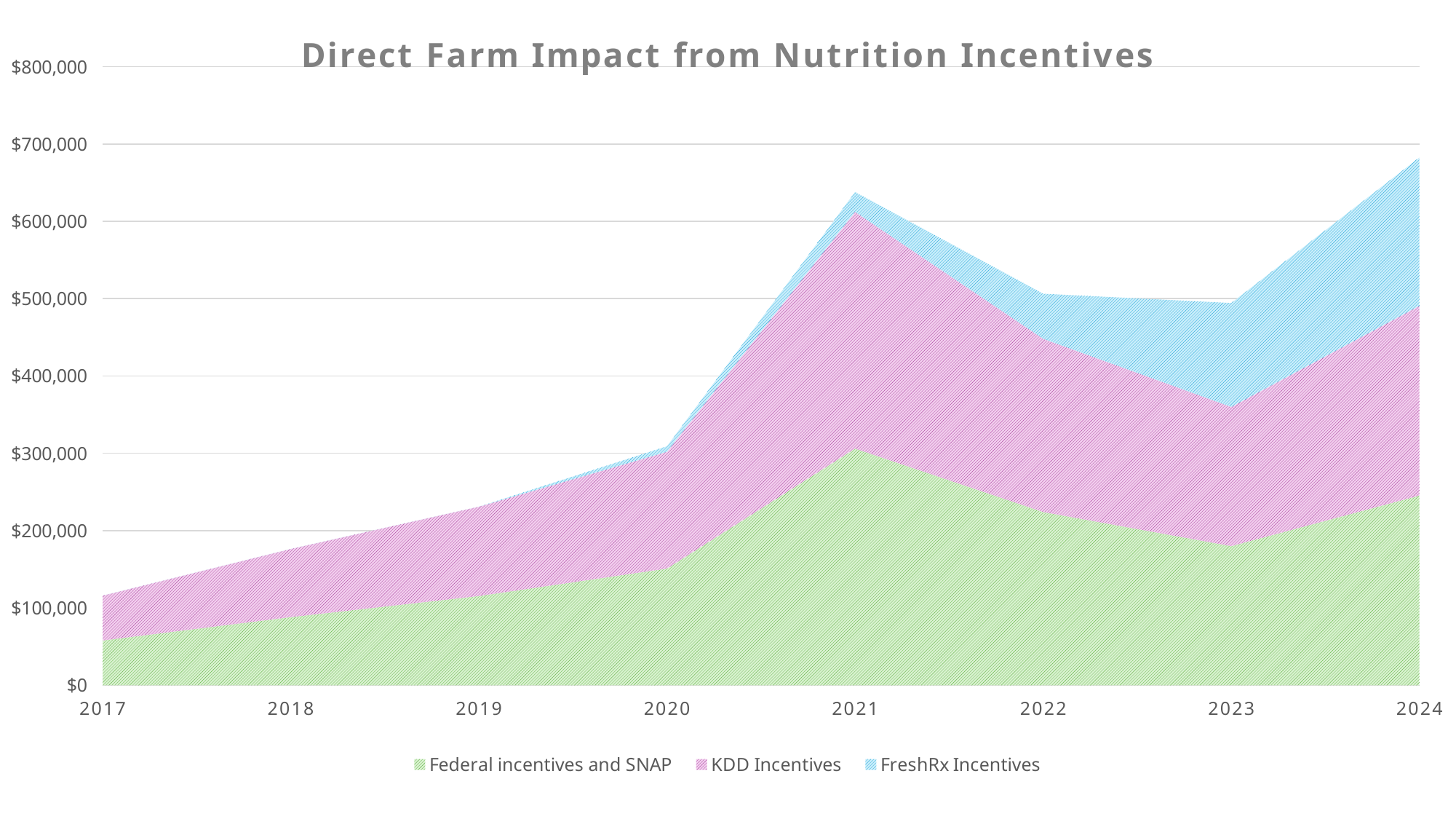
Is the total stacked value for 2024 greater or less than $600,000? greater How many years are shown along the x axis? 8 What kind of chart is shown on the slide? Stacked area chart Which series is shown in green at the bottom of the stack? Federal incentives and SNAP In which year is the total stacked value highest? 2024 In which year is the total stacked value lowest? 2017 Is the total stacked value for 2017 greater or less than $200,000? less How many series does the legend list? 3 What is the title of the chart? Direct Farm Impact from Nutrition Incentives In which year does the Federal incentives and SNAP series reach its highest value? 2021 Does the total stacked value rise or fall from 2021 to 2023? fall Is the total stacked value larger in 2021 or in 2022? 2021